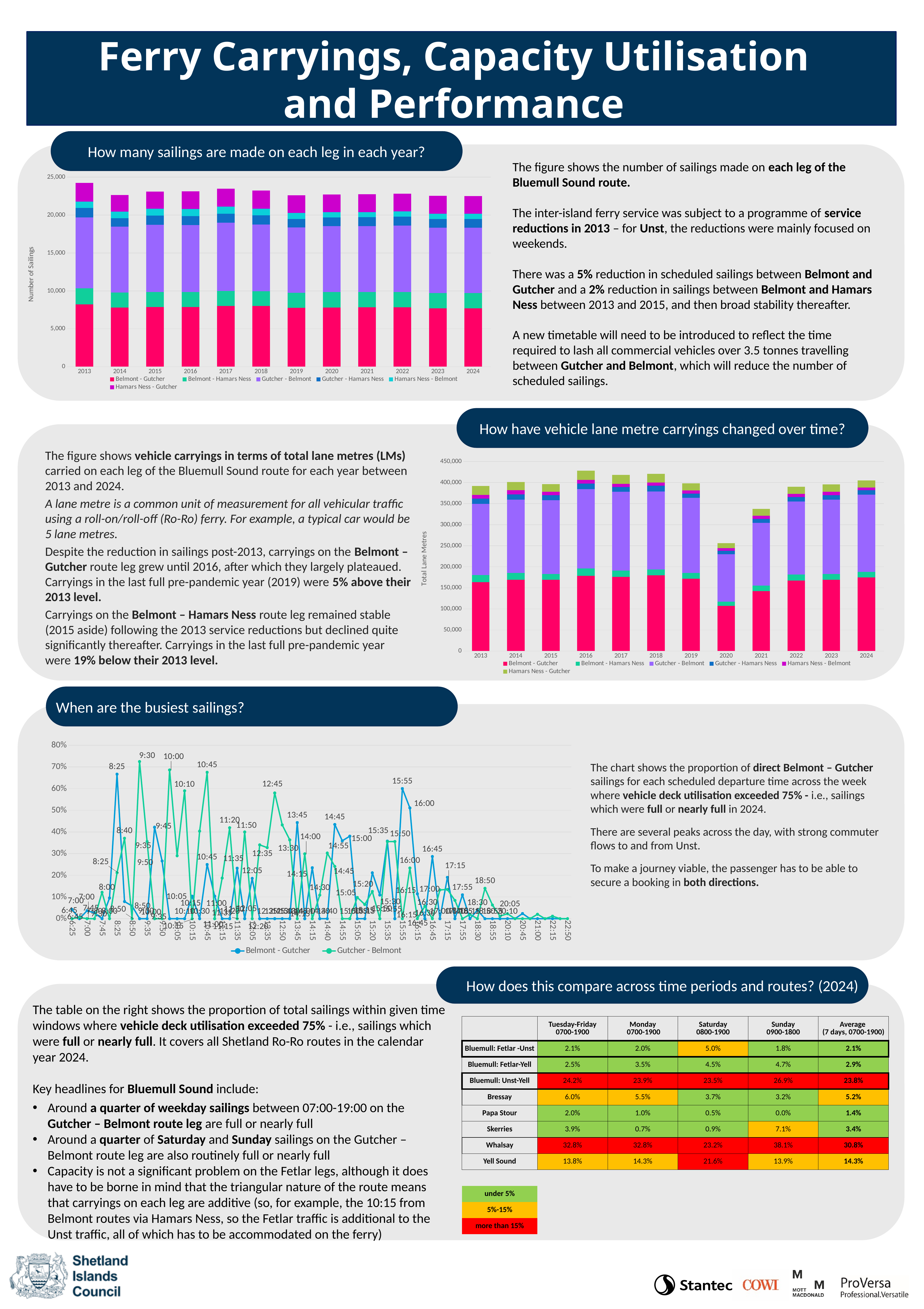
In the chart 'How have vehicle lane metre carryings changed over time?', is the total for 2020 greater or less than 300,000? less In the chart 'How many sailings are made on each leg in each year?', how many years are shown on the x axis? 12 In the chart 'When are the busiest sailings?', what kind of chart is shown? line chart In the chart 'When are the busiest sailings?', is the Belmont - Gutcher value at 8:25 greater or less than 60%? greater In the chart 'How many sailings are made on each leg in each year?', what kind of chart is shown? bar chart In the chart 'When are the busiest sailings?', how many series does the legend list? 2 In the chart 'How have vehicle lane metre carryings changed over time?', which year has the lowest total lane metres? 2020 In the chart 'How many sailings are made on each leg in each year?', how many series does the legend list? 6 In the chart 'How many sailings are made on each leg in each year?', which year has the tallest stacked bar? 2013 In the chart 'How many sailings are made on each leg in each year?', is the Belmont - Gutcher value for 2013 greater or less than 10,000? less In the chart 'How have vehicle lane metre carryings changed over time?', what is the label of the y axis? Total Lane Metres